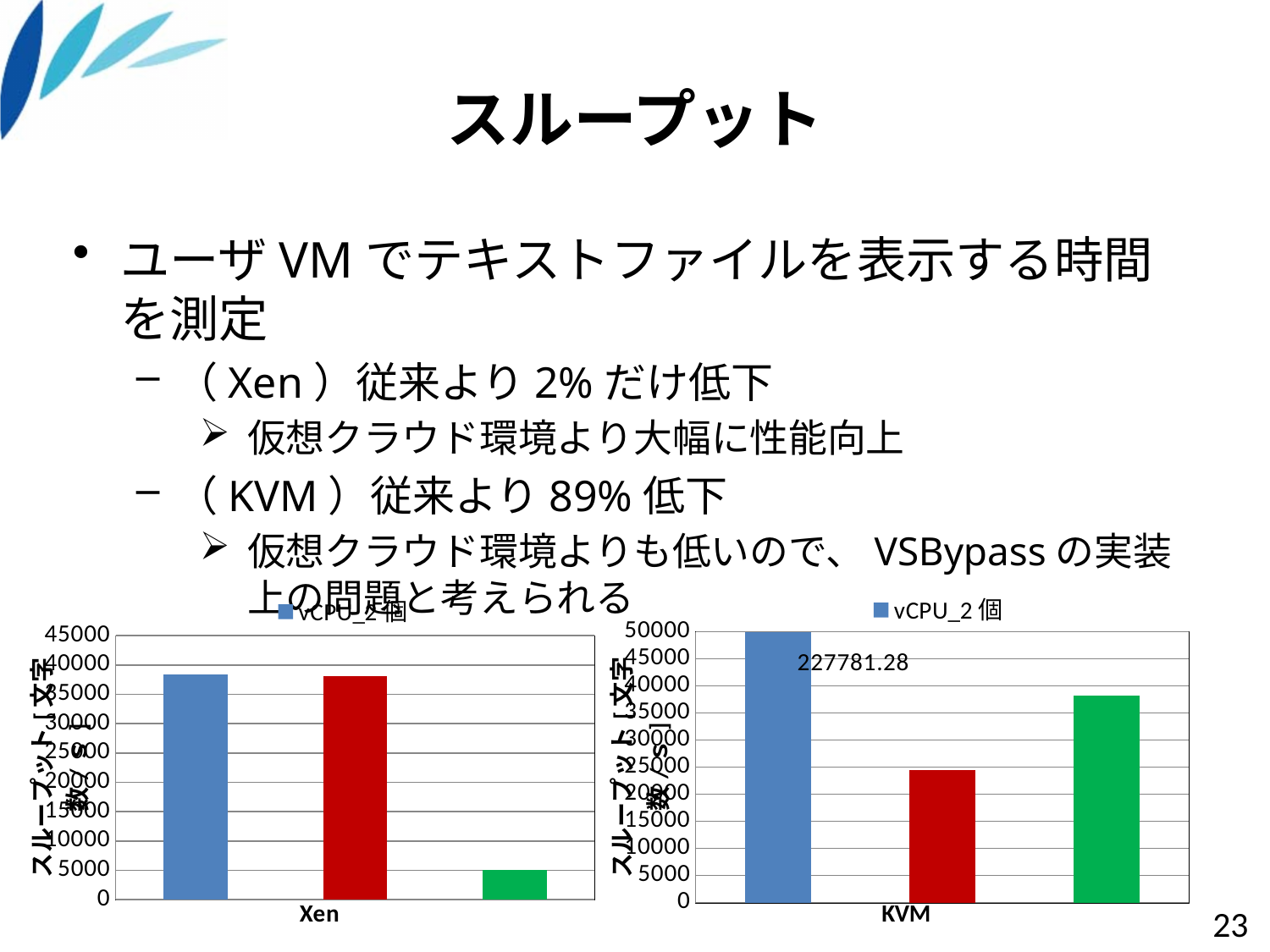
In the right chart labelled KVM, which bar is the highest? the blue bar In the right chart labelled KVM, is the value of the green bar greater or less than 35000? greater In the left chart labelled Xen, is the value of the green bar greater or less than 10000? less What kind of chart is the left chart labelled Xen? bar chart In the left chart labelled Xen, which bar is the lowest? the green bar In the left chart labelled Xen, is the value of the blue bar greater or less than 35000? greater In the right chart labelled KVM, what value is printed as the data label on the blue bar? 227781.28 How many bars are plotted in the left chart labelled Xen? 3 In the right chart labelled KVM, which bar is the lowest? the red bar What legend entry is shown above the right chart labelled KVM? vCPU_2個 How many bars are plotted in the right chart labelled KVM? 3